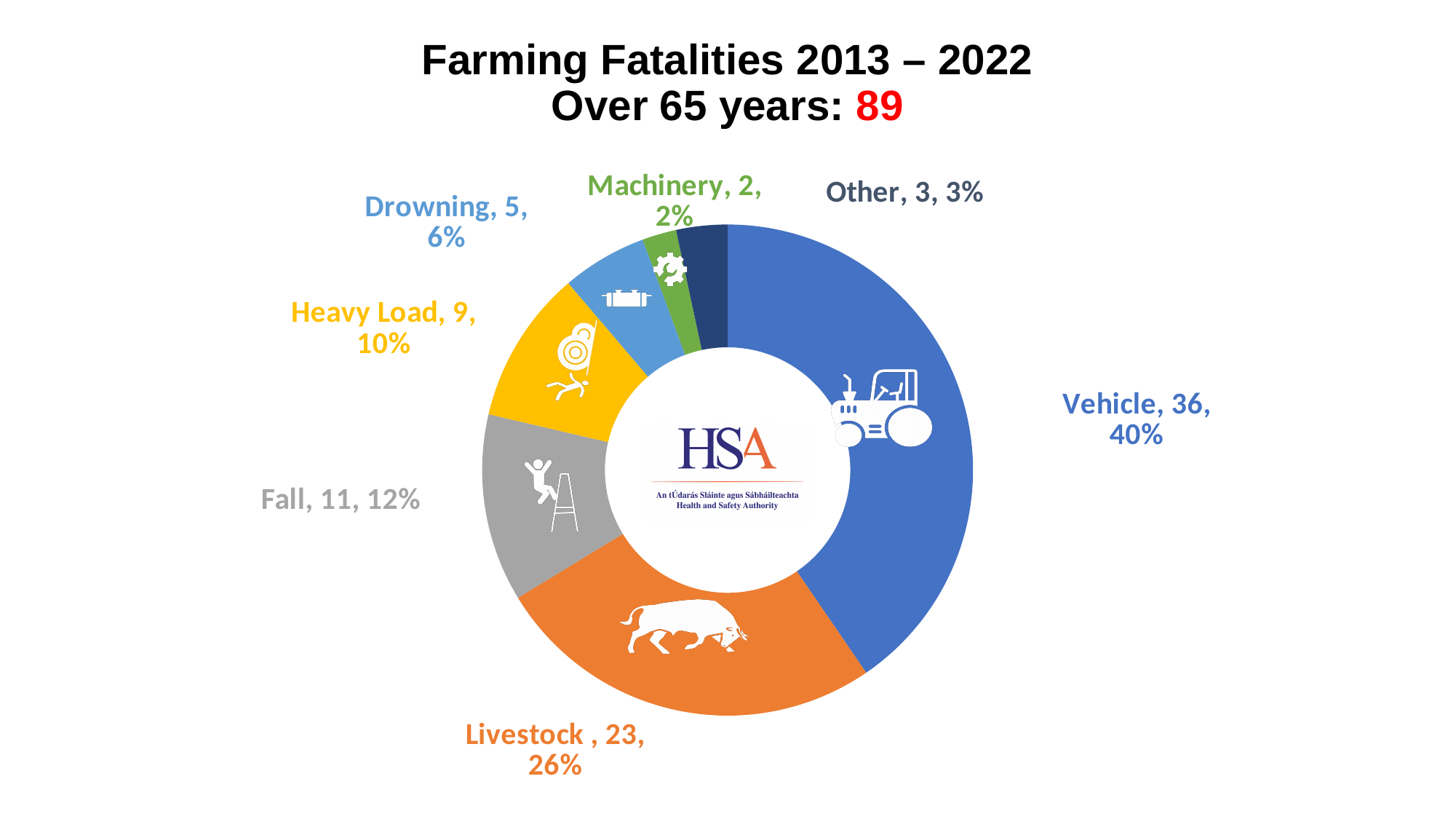
Which cause accounts for the largest share of fatalities? Vehicle What is the total number of fatalities for those over 65 years shown in the title? 89 What kind of chart is shown on the slide? Pie chart (doughnut) What percentage of fatalities is attributed to Heavy Load? 10% How many fatalities were caused by Fall? 11 How many categories are shown in the chart? 7 What is the combined number of fatalities from Drowning and Machinery? 7 What is the difference between the number of Vehicle fatalities and Livestock fatalities? 13 What percentage of the fatalities is attributed to Livestock? 26% How many farming fatalities among those over 65 years were attributed to Vehicle? 36 Which cause accounts for the smallest share of fatalities? Machinery Which has more fatalities, Heavy Load or Drowning? Heavy Load